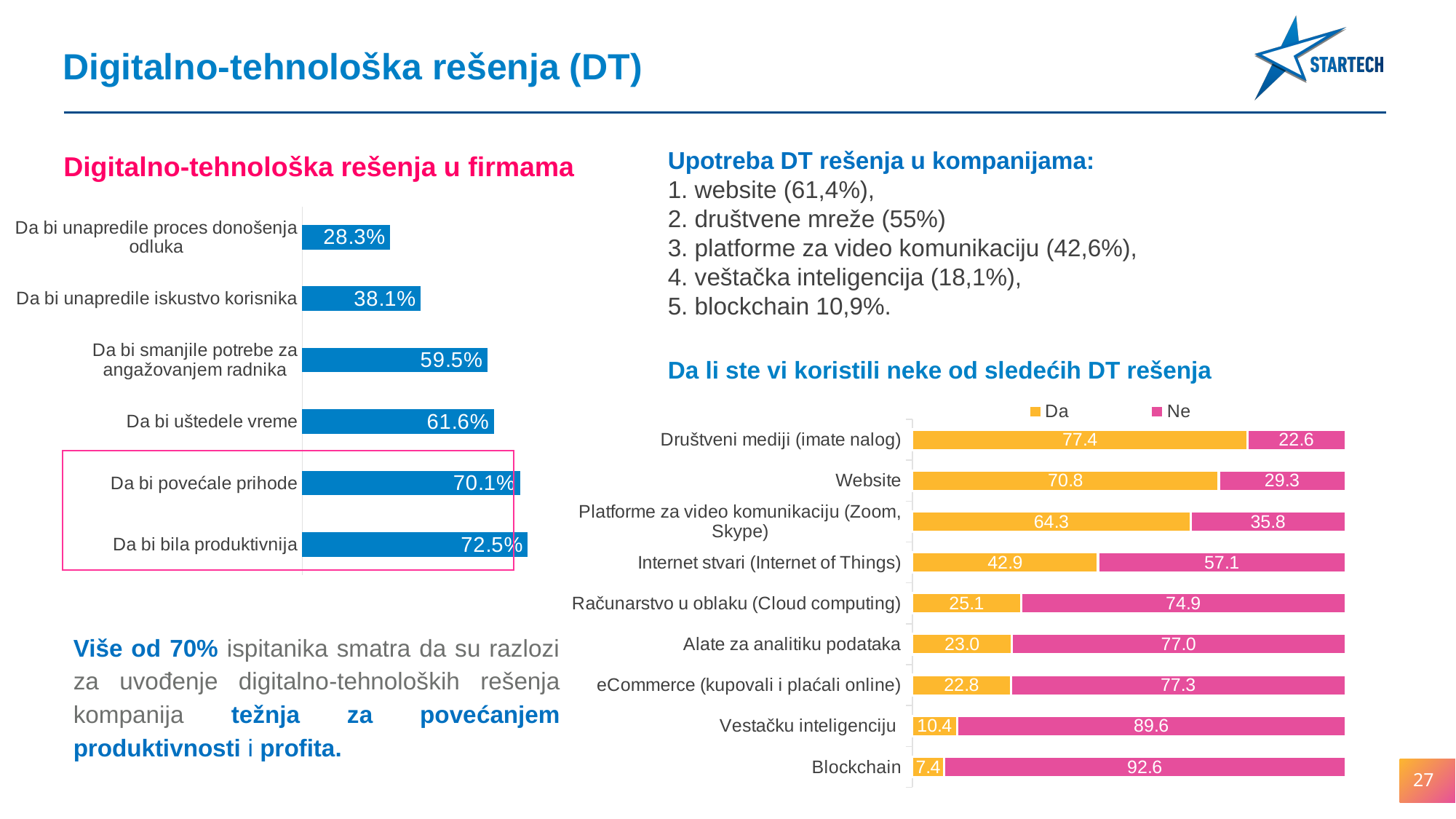
In the chart 'Da li ste vi koristili neke od sledećih DT rešenja', which category has the highest 'Da' value? Društveni mediji (imate nalog) In the chart 'Digitalno-tehnološka rešenja u firmama', which category has the highest value? Da bi bila produktivnija In the chart 'Da li ste vi koristili neke od sledećih DT rešenja', how many series does the legend list? 2 In the chart 'Da li ste vi koristili neke od sledećih DT rešenja', is the 'Da' value larger for 'Internet stvari (Internet of Things)' or for 'Računarstvo u oblaku (Cloud computing)'? Internet stvari (Internet of Things) In the chart 'Da li ste vi koristili neke od sledećih DT rešenja', what is the 'Ne' value for 'Blockchain'? 92.6 How many categories are shown in the chart 'Da li ste vi koristili neke od sledećih DT rešenja'? 9 What kind of chart is 'Digitalno-tehnološka rešenja u firmama'? Bar chart How many categories are shown in the chart 'Digitalno-tehnološka rešenja u firmama'? 6 In the chart 'Da li ste vi koristili neke od sledećih DT rešenja', what is the 'Da' value for 'Website'? 70.8 In the chart 'Digitalno-tehnološka rešenja u firmama', what is the difference between 'Da bi bila produktivnija' and 'Da bi povećale prihode'? 2.4% In the chart 'Digitalno-tehnološka rešenja u firmama', which category has the lowest value? Da bi unapredile proces donošenja odluka In the chart 'Digitalno-tehnološka rešenja u firmama', what is the value for 'Da bi uštedele vreme'? 61.6%